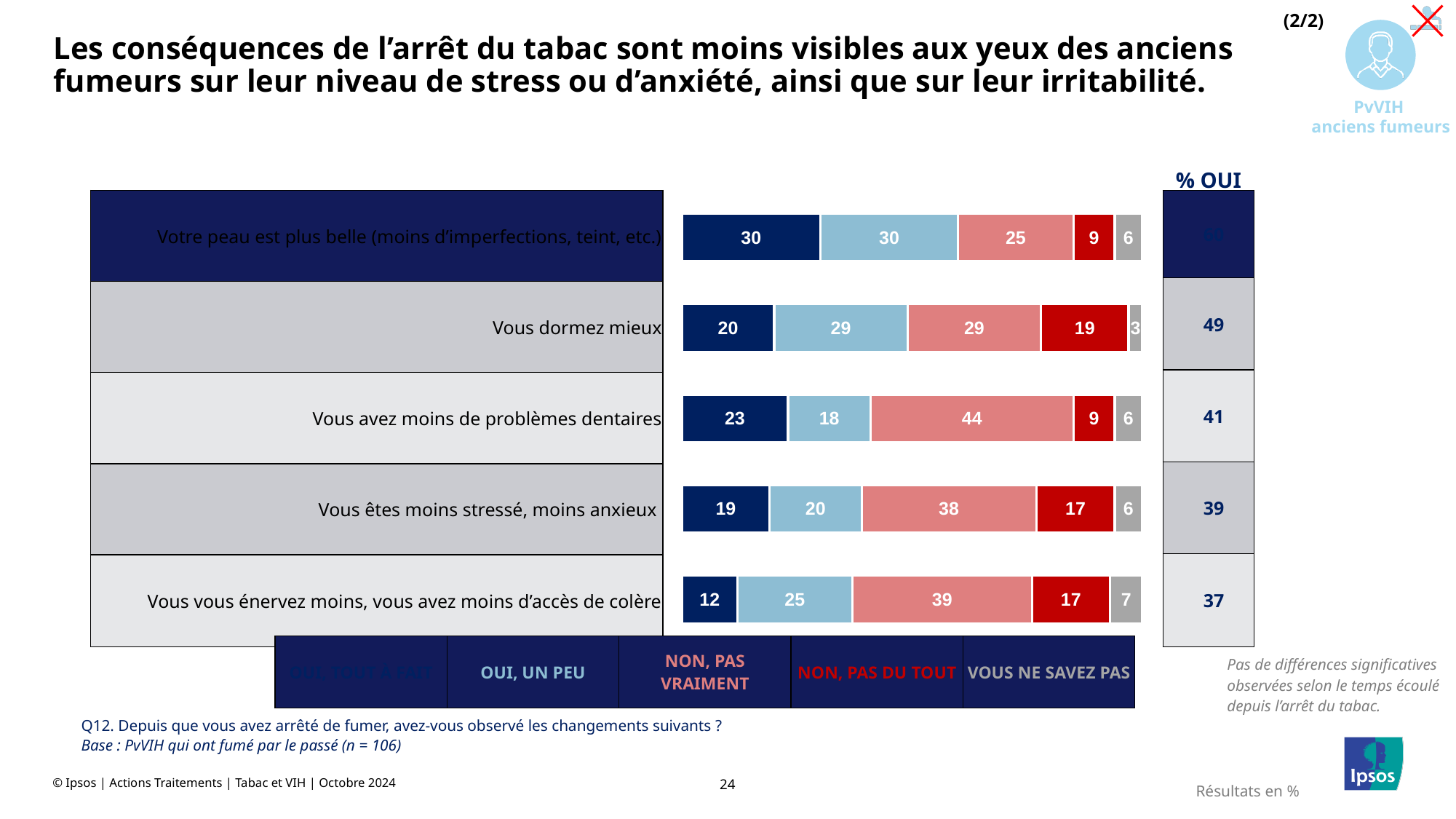
In the stacked bar chart, what is the value of the 'OUI, UN PEU' segment for 'Vous dormez mieux'? 29 Which category has the highest 'NON, PAS VRAIMENT' value? Vous avez moins de problèmes dentaires In the stacked bar chart, what is the value of the 'NON, PAS VRAIMENT' segment for 'Vous avez moins de problèmes dentaires'? 44 Which category has the lowest 'OUI, UN PEU' value? Vous avez moins de problèmes dentaires In the stacked bar chart, what is the value of the 'VOUS NE SAVEZ PAS' segment for 'Vous vous énervez moins, vous avez moins d'accès de colère'? 7 How many categories (rows) are shown in the stacked bar chart? 5 What is the difference between the 'NON, PAS DU TOUT' value for 'Vous dormez mieux' and the 'NON, PAS DU TOUT' value for 'Votre peau est plus belle (moins d'imperfections, teint, etc.)'? 10 How many series does the legend of the stacked bar chart list? 5 In the stacked bar chart, what is the value of the 'NON, PAS DU TOUT' segment for 'Vous êtes moins stressé, moins anxieux'? 17 What kind of chart is used to show the responses to Q12? Stacked bar chart In the '% OUI' column, what is the value for 'Vous êtes moins stressé, moins anxieux'? 39 Which has the larger 'OUI, UN PEU' value: 'Votre peau est plus belle (moins d'imperfections, teint, etc.)' or 'Vous vous énervez moins, vous avez moins d'accès de colère'? Votre peau est plus belle (moins d'imperfections, teint, etc.)